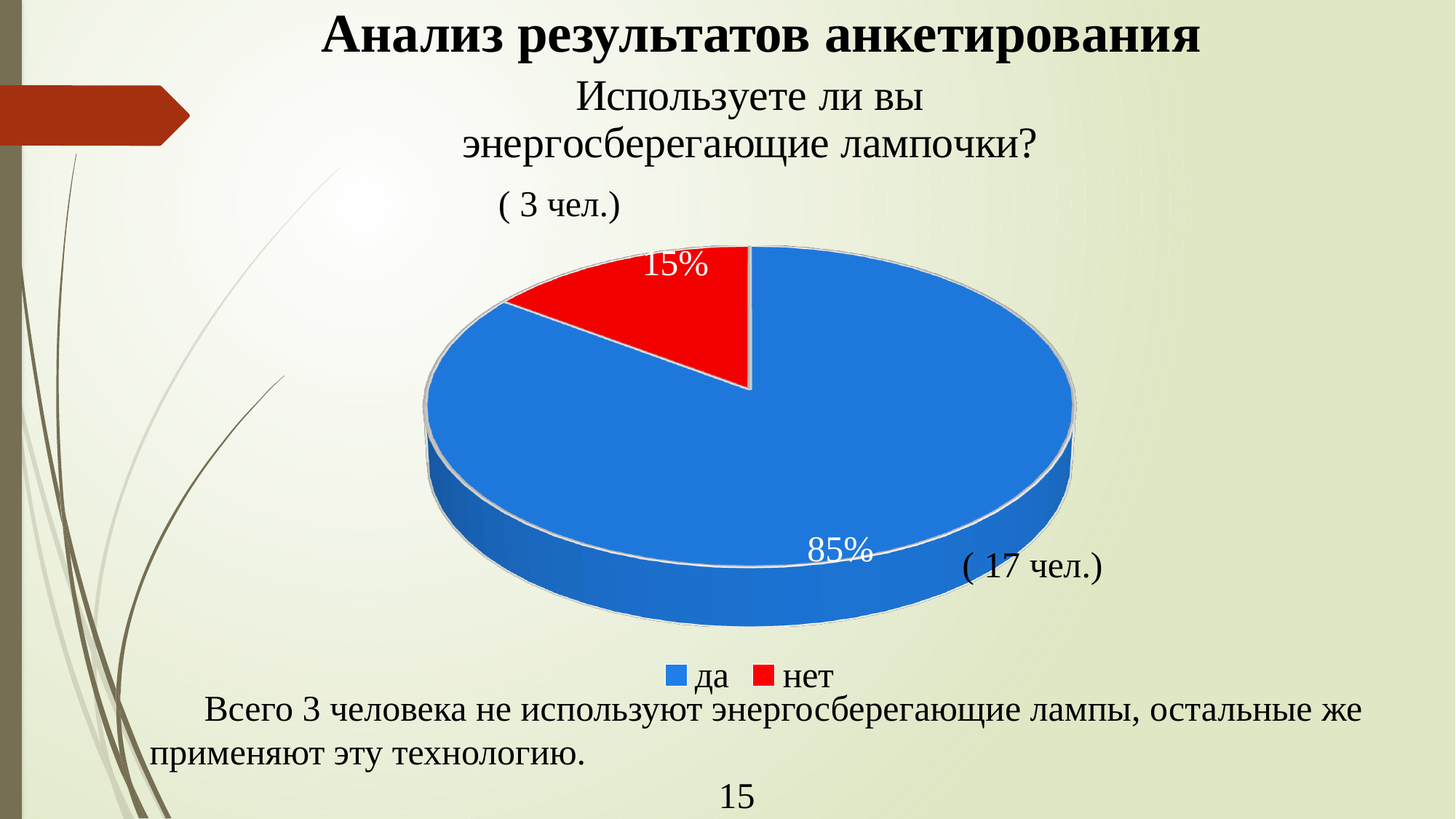
How many people are indicated next to the "нет" slice? 3 чел. What is the difference in percentage points between the "да" and "нет" slices? 70 What share of the pie does the "нет" slice represent? 15% Which category has the largest slice of the pie? да What colour is the "нет" slice in the pie chart? red Which category has the smallest slice of the pie? нет How many entries does the legend list? 2 What share of the pie does the "да" slice represent? 85% What kind of chart is shown on the slide? pie chart Which slice is larger, "да" or "нет"? да How many categories does the pie chart show? 2 How many people are indicated next to the "да" slice? 17 чел.